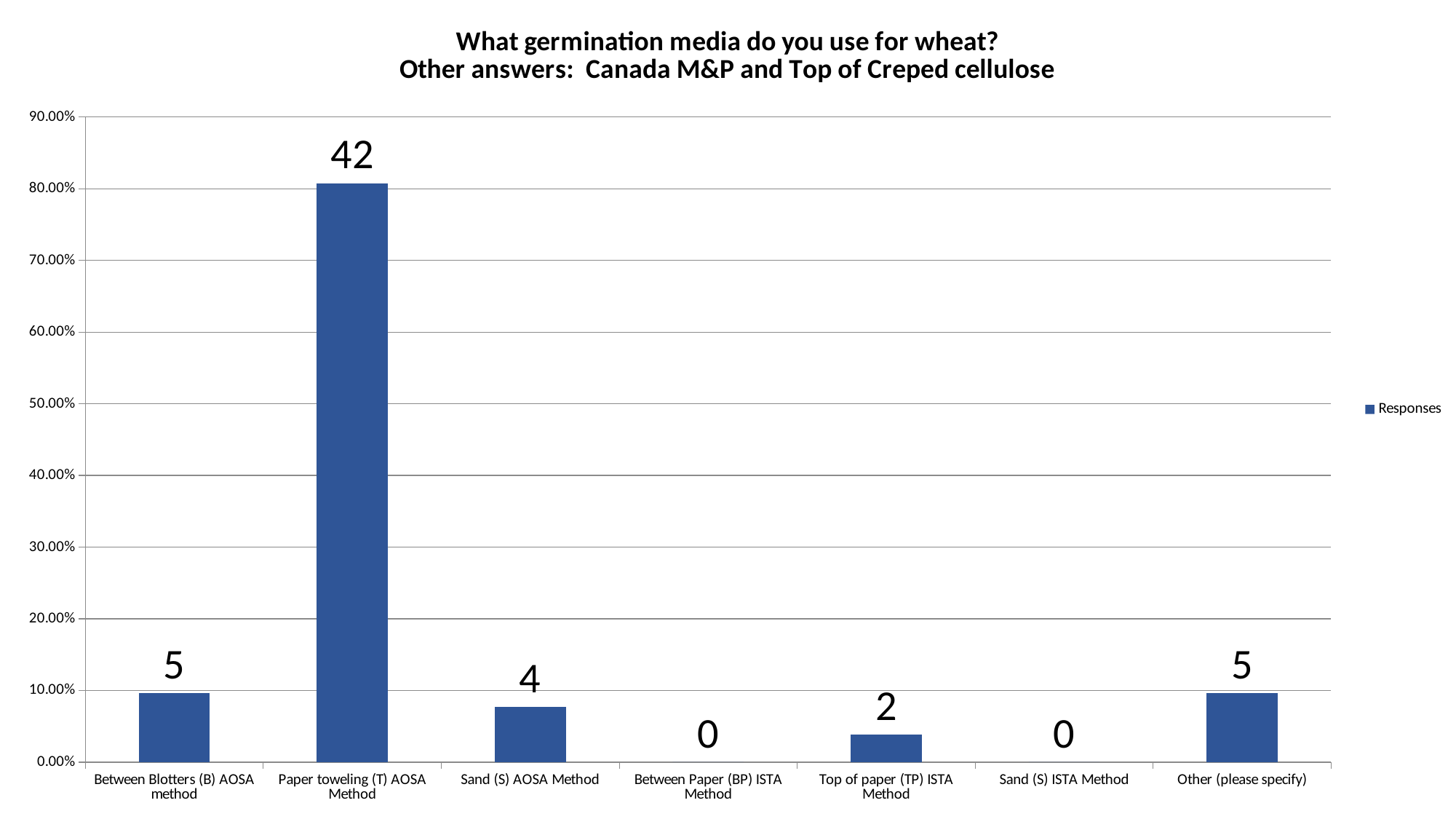
What is the difference between the data labels for Paper toweling (T) AOSA Method and Between Blotters (B) AOSA method? 37 What is the data label shown for Top of paper (TP) ISTA Method? 2 What is the data label shown for Sand (S) AOSA Method? 4 What is the data label shown for Paper toweling (T) AOSA Method? 42 How many categories are shown on the x axis? 7 Is the value for Between Blotters (B) AOSA method greater or less than 20.00%? less What is the data label shown for Other (please specify)? 5 How many series does the legend list? 1 Is the value for Paper toweling (T) AOSA Method greater or less than 70.00%? greater What kind of chart is shown? Bar chart Which has a larger value, Sand (S) AOSA Method or Top of paper (TP) ISTA Method? Sand (S) AOSA Method Which category has the highest bar? Paper toweling (T) AOSA Method